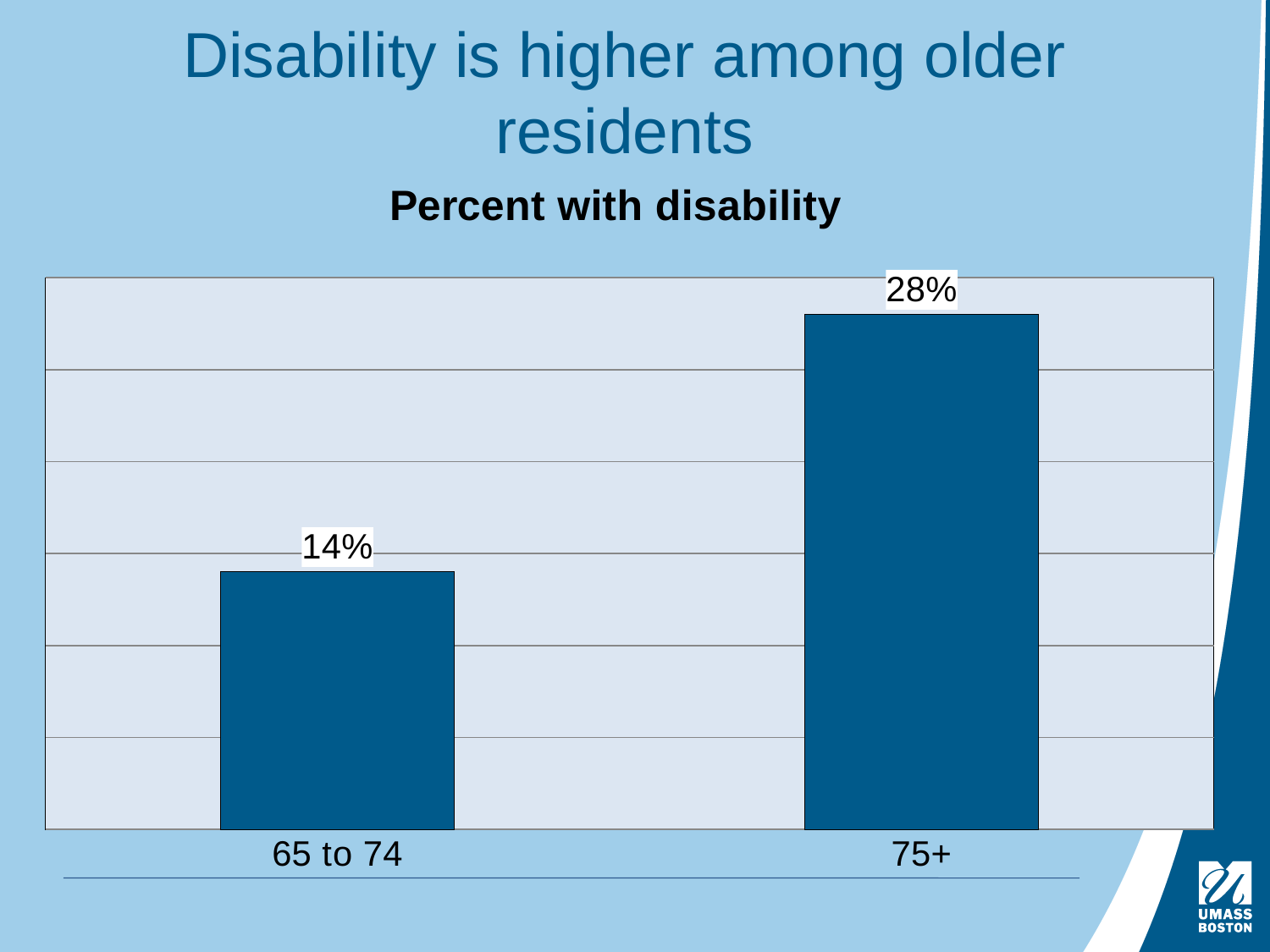
What is the difference in percent with disability between the 75+ group and the 65 to 74 group? 14% Which group has a larger percent with disability, 65 to 74 or 75+? 75+ What is the percent with disability for residents aged 75+? 28% What colour are the bars in the chart? Dark blue Which age group has the lowest percent with disability? 65 to 74 What kind of chart is shown on the slide? Bar chart Which age group has the highest percent with disability? 75+ What is the percent with disability for residents aged 65 to 74? 14% What is the title of the chart? Percent with disability Do the values rise or fall from the 65 to 74 group to the 75+ group? Rise How many age groups are shown in the chart? 2